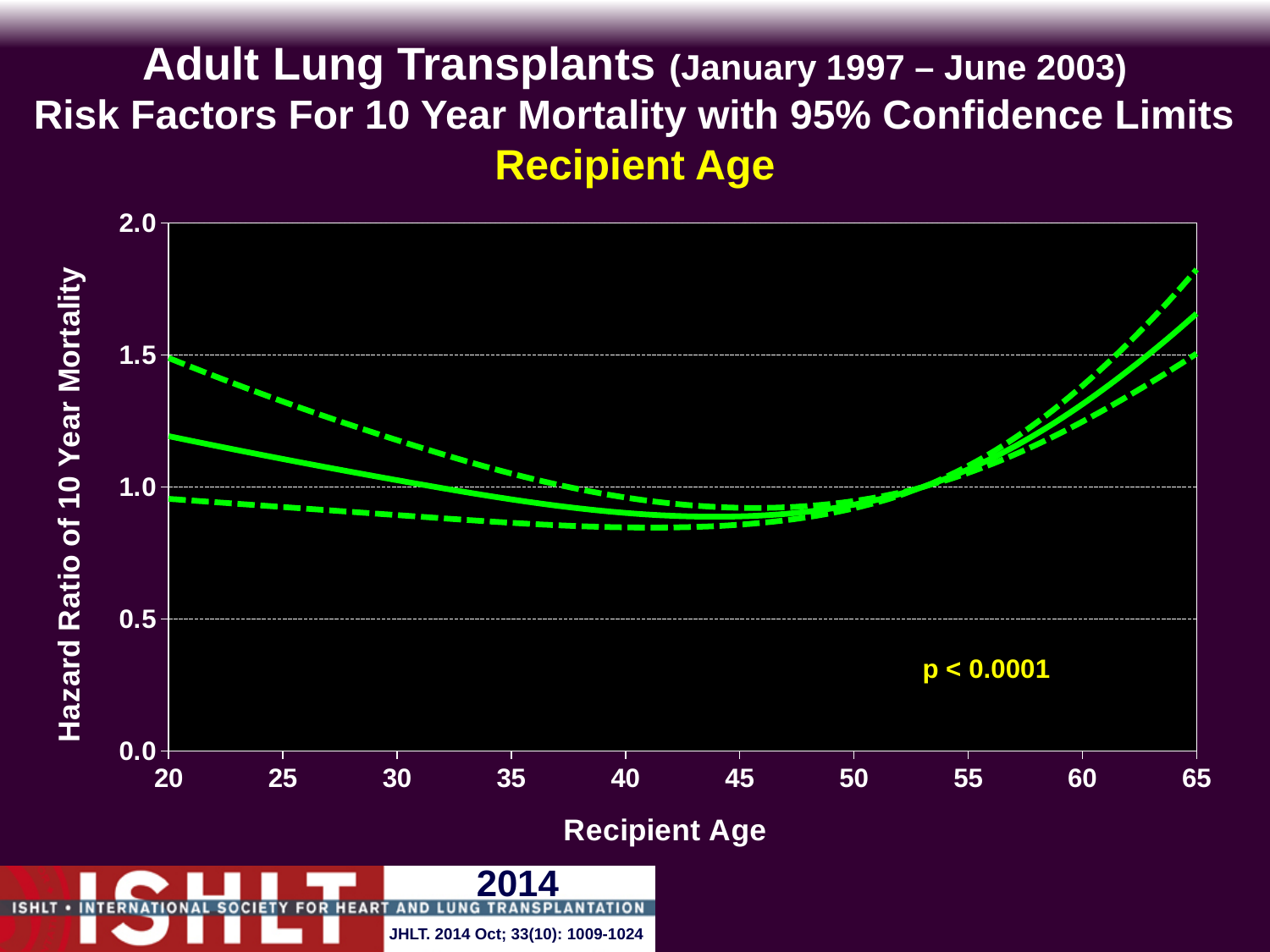
Does the solid hazard ratio line rise or fall as recipient age increases from 50 to 65? rise At which recipient age shown on the x axis is the solid hazard ratio line highest? 65 What is the title of the chart's y axis? Hazard Ratio of 10 Year Mortality Is the lower dashed confidence limit at recipient age 40 greater or less than 1.0? less Is the hazard ratio on the solid line at recipient age 20 greater or less than 1.0? greater Does the solid hazard ratio line rise or fall as recipient age increases from 20 to 45? fall What p-value is printed on the chart? p < 0.0001 Is the hazard ratio on the solid line at recipient age 40 greater or less than 1.0? less What kind of chart is shown on the slide? line chart How many lines are plotted on the chart? 3